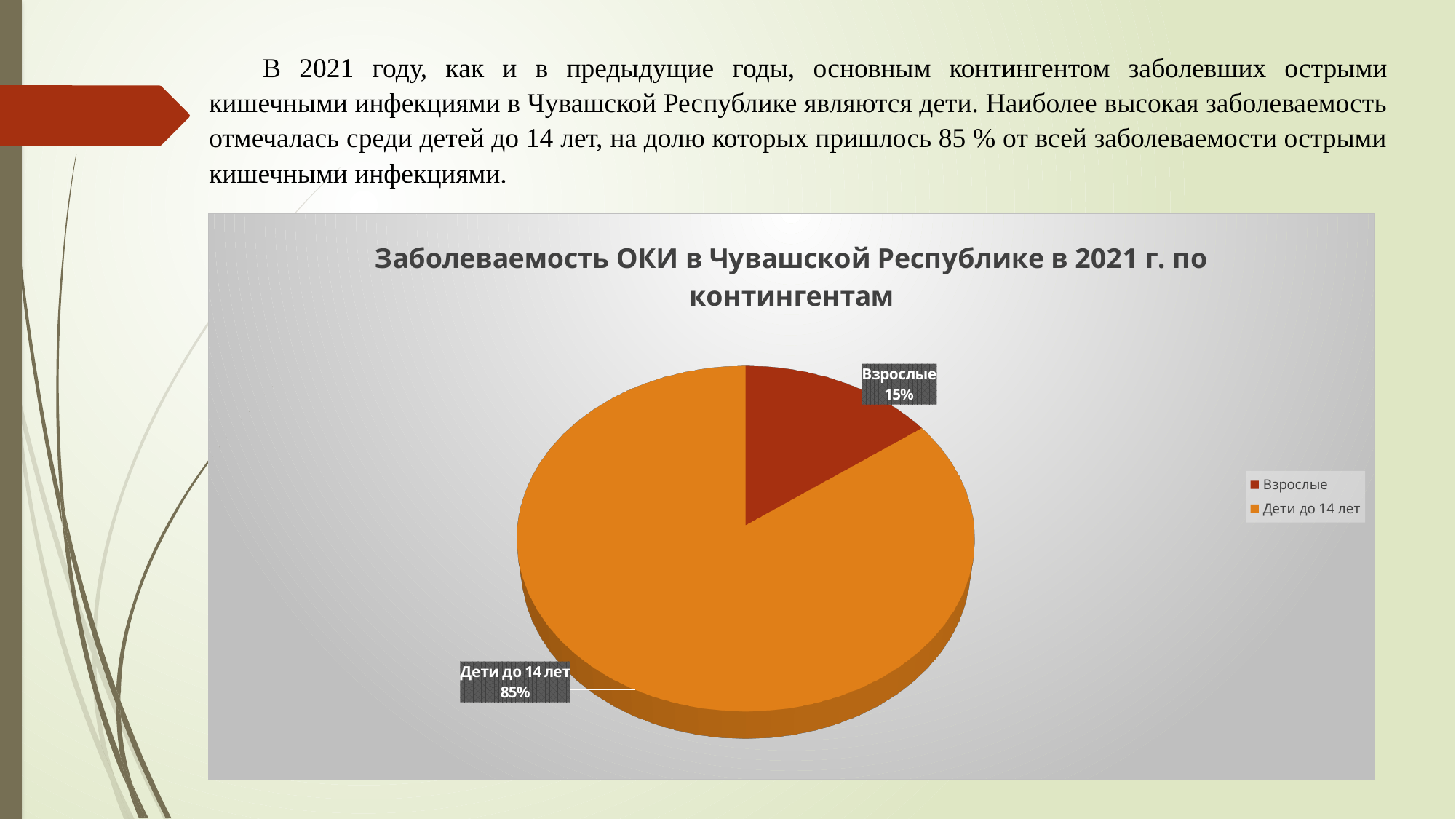
How many categories are shown in the pie chart? 2 What share of the pie does the slice for Взрослые represent? 15% What is the title of the chart? Заболеваемость ОКИ в Чувашской Республике в 2021 г. по контингентам Which category has the smallest slice of the pie? Взрослые What colour is the slice for Взрослые? Dark red What share of the pie does the slice for Дети до 14 лет represent? 85% Which category has the largest slice of the pie? Дети до 14 лет What kind of chart is shown on the slide? Pie chart What is the difference in percentage points between the Дети до 14 лет slice and the Взрослые slice? 70 percentage points How many entries does the legend list? 2 Which slice is larger, Взрослые or Дети до 14 лет? Дети до 14 лет